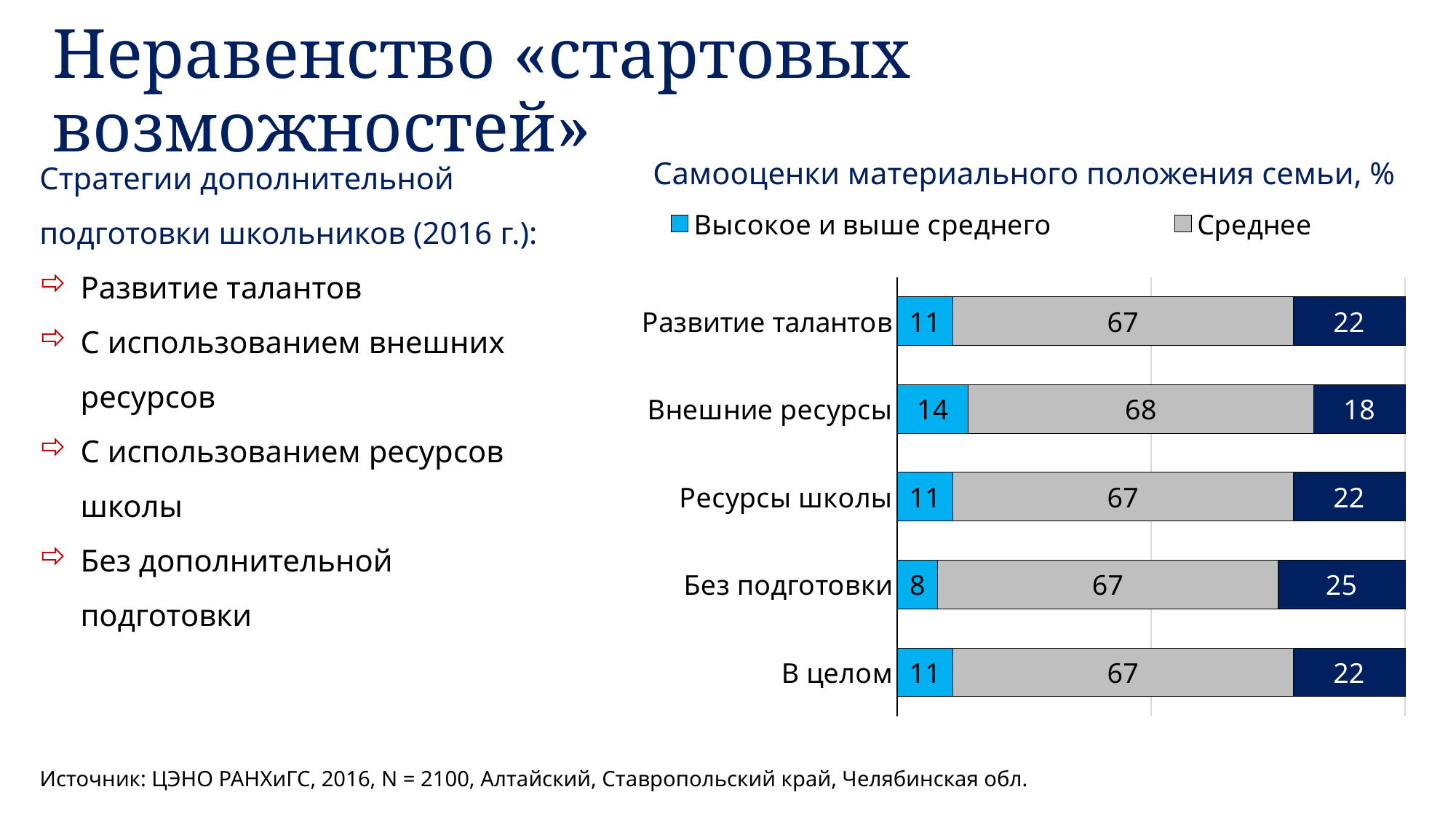
Which category has the lowest value for «Высокое и выше среднего»? Без подготовки What is the difference between the «Высокое и выше среднего» values for «Внешние ресурсы» and «Без подготовки»? 6 What kind of chart is shown on the slide? Stacked bar chart Which category has the highest value for «Высокое и выше среднего»? Внешние ресурсы What is the value of «Высокое и выше среднего» for «Внешние ресурсы»? 14 What is the title of the chart? Самооценки материального положения семьи, % What is the value of «Высокое и выше среднего» for «Без подготовки»? 8 What is the value of the dark blue segment for «Без подготовки»? 25 How many categories are shown on the chart? 5 What is the total of the stacked bar for «Развитие талантов»? 100 What is the value of «Среднее» for «Без подготовки»? 67 Which has the larger «Среднее» value: «Внешние ресурсы» or «Развитие талантов»? Внешние ресурсы